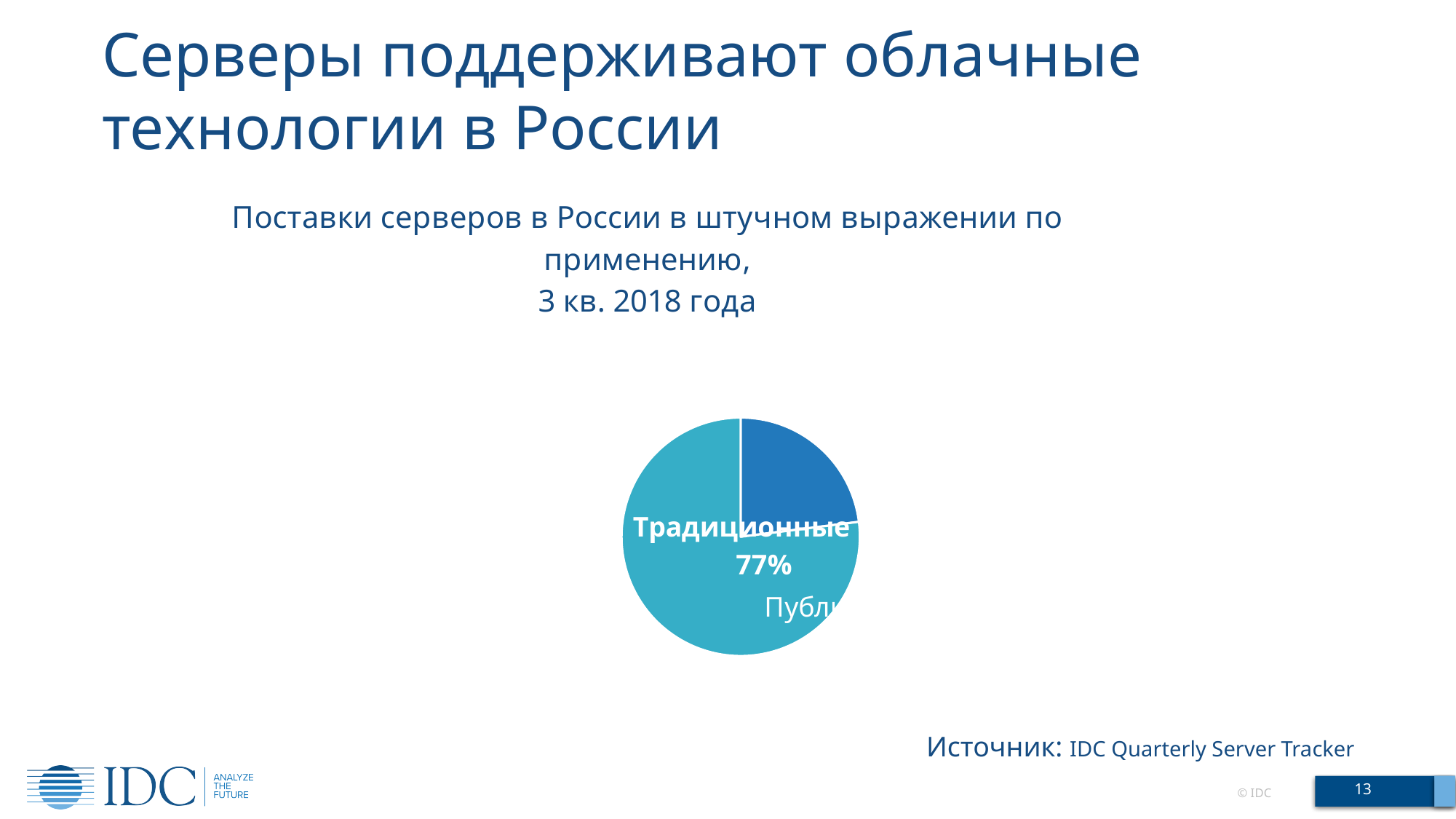
Which slice of the pie chart is the largest? Традиционные What source is cited for the chart data? IDC Quarterly Server Tracker How many slices does the pie chart have? 2 What is the title of the chart? Поставки серверов в России в штучном выражении по применению, 3 кв. 2018 года What share of the pie does the Традиционные slice represent? 77% Is the share for Традиционные greater or less than 50%? greater What kind of chart is shown on the slide? pie chart